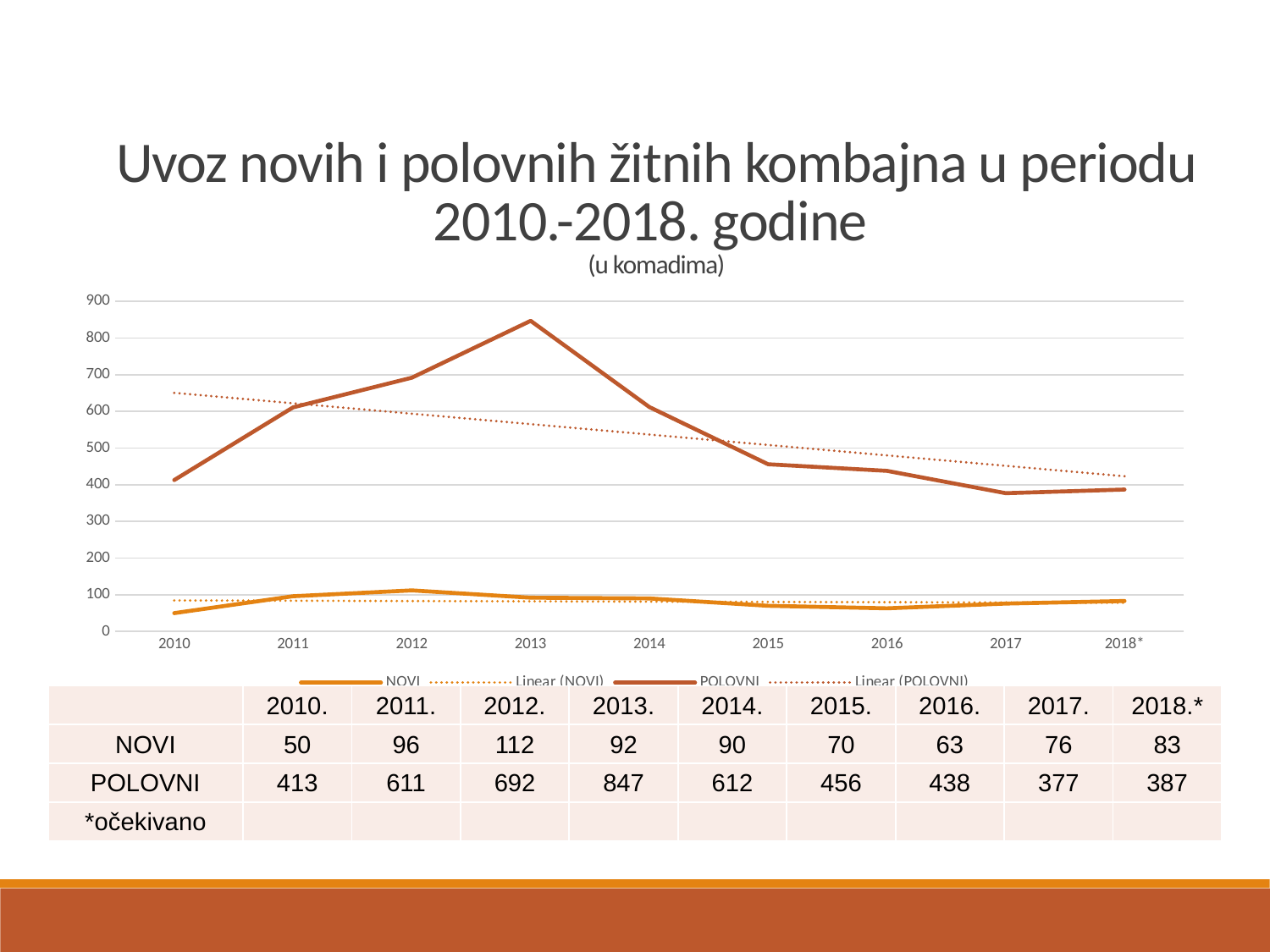
In which year is the POLOVNI series highest? 2013 In which year is the NOVI series lowest? 2010 What kind of chart is shown on the slide? line chart How many years are shown on the x axis? 9 What is the difference between POLOVNI and NOVI in 2013? 755 What is the value for POLOVNI in 2013? 847 Is the POLOVNI value for 2012 greater or less than 600? greater In which year is the POLOVNI series lowest? 2017 How many entries does the legend list? 4 Does the POLOVNI series rise or fall from 2013 to 2017? fall What is the value for NOVI in 2010? 50 Which is larger, the NOVI value in 2012 or the NOVI value in 2016? 2012